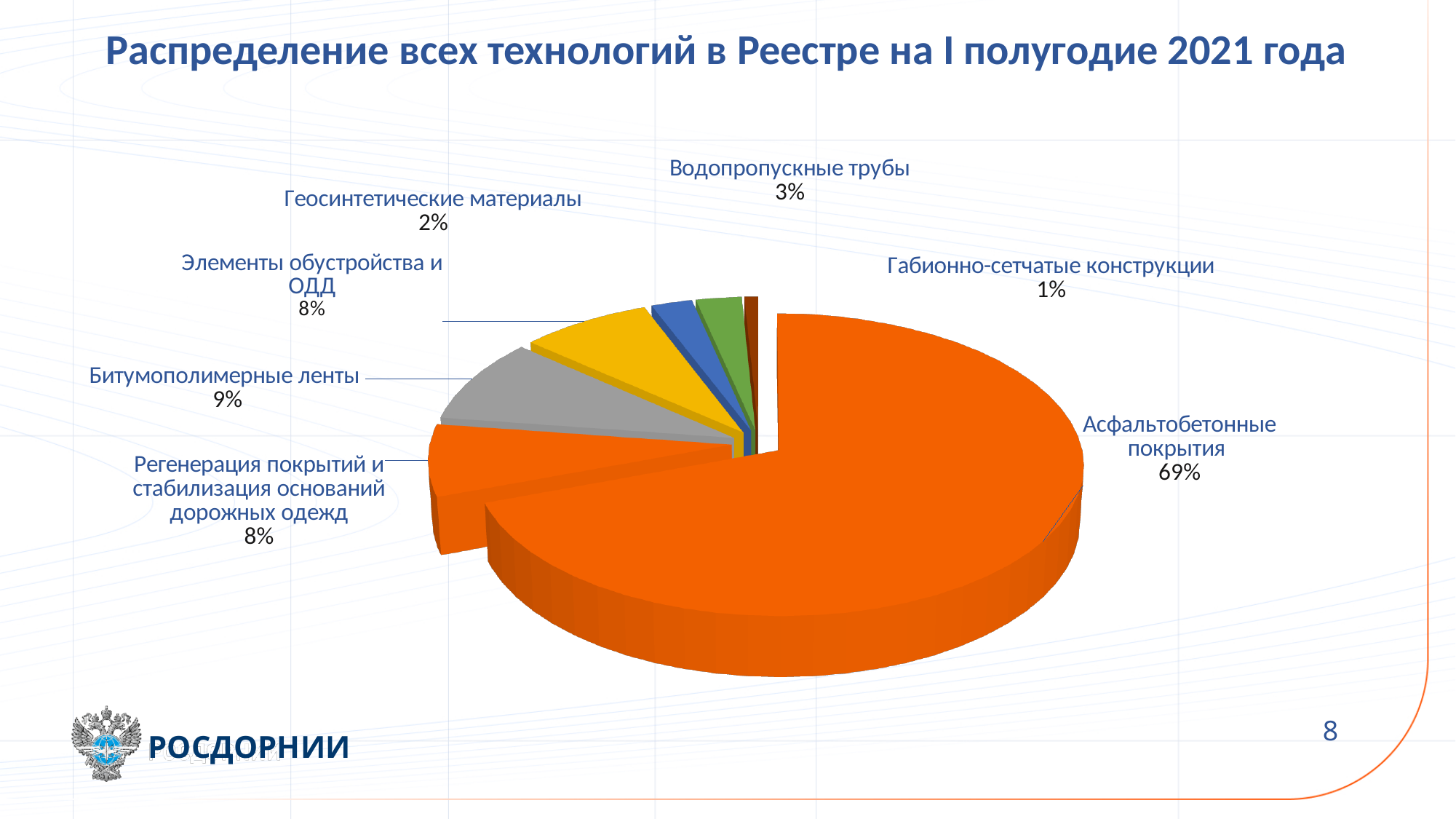
Какую долю занимают «Габионно-сетчатые конструкции»? 1% Какая категория имеет наименьшую долю? Габионно-сетчатые конструкции Какой тип диаграммы показан на слайде? Круговая диаграмма Сколько категорий показано на диаграмме? 7 Какую долю занимают «Элементы обустройства и ОДД»? 8% Какую долю занимают «Битумополимерные ленты»? 9% Какую долю занимают «Асфальтобетонные покрытия»? 69% Что больше: доля «Водопропускных труб» или доля «Геосинтетических материалов»? Водопропускные трубы На сколько процентных пунктов доля «Асфальтобетонных покрытий» больше доли «Битумополимерных лент»? 60 Какая категория имеет наибольшую долю? Асфальтобетонные покрытия Какую долю занимают «Водопропускные трубы»? 3% Как называется диаграмма на слайде? Распределение всех технологий в Реестре на I полугодие 2021 года